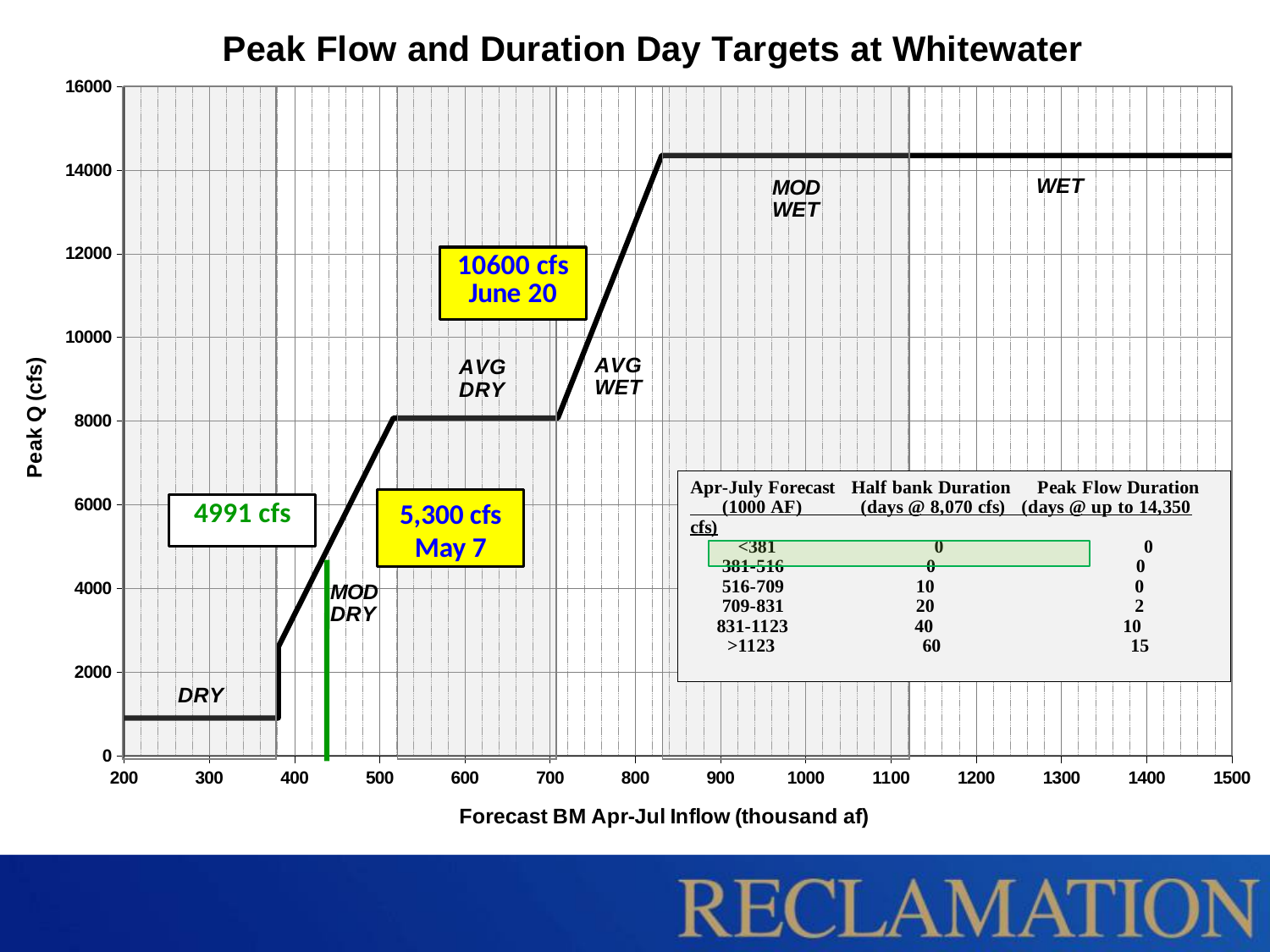
Is the peak flow value at a forecast inflow of 300 greater or less than 2000? less Which has the larger peak flow value: a forecast inflow of 300 or a forecast inflow of 1200? 1200 Is the peak flow value at a forecast inflow of 1000 greater or less than 12000? greater Does the peak flow line rise or fall as forecast inflow increases from 400 to 800? rises What kind of chart is shown on the slide? line chart What is the title of the chart? Peak Flow and Duration Day Targets at Whitewater What flow value is shown in the annotation box dated June 20? 10600 cfs How many hydrologic condition labels (DRY, MOD DRY, etc.) are shown on the chart? 6 Is the peak flow value at a forecast inflow of 600 greater or less than 6000? greater In the table on the chart, what is the Peak Flow Duration for an Apr-July Forecast of >1123? 15 In the table on the chart, what is the Half bank Duration for an Apr-July Forecast of 831-1123? 40 What is the label of the x axis? Forecast BM Apr-Jul Inflow (thousand af)